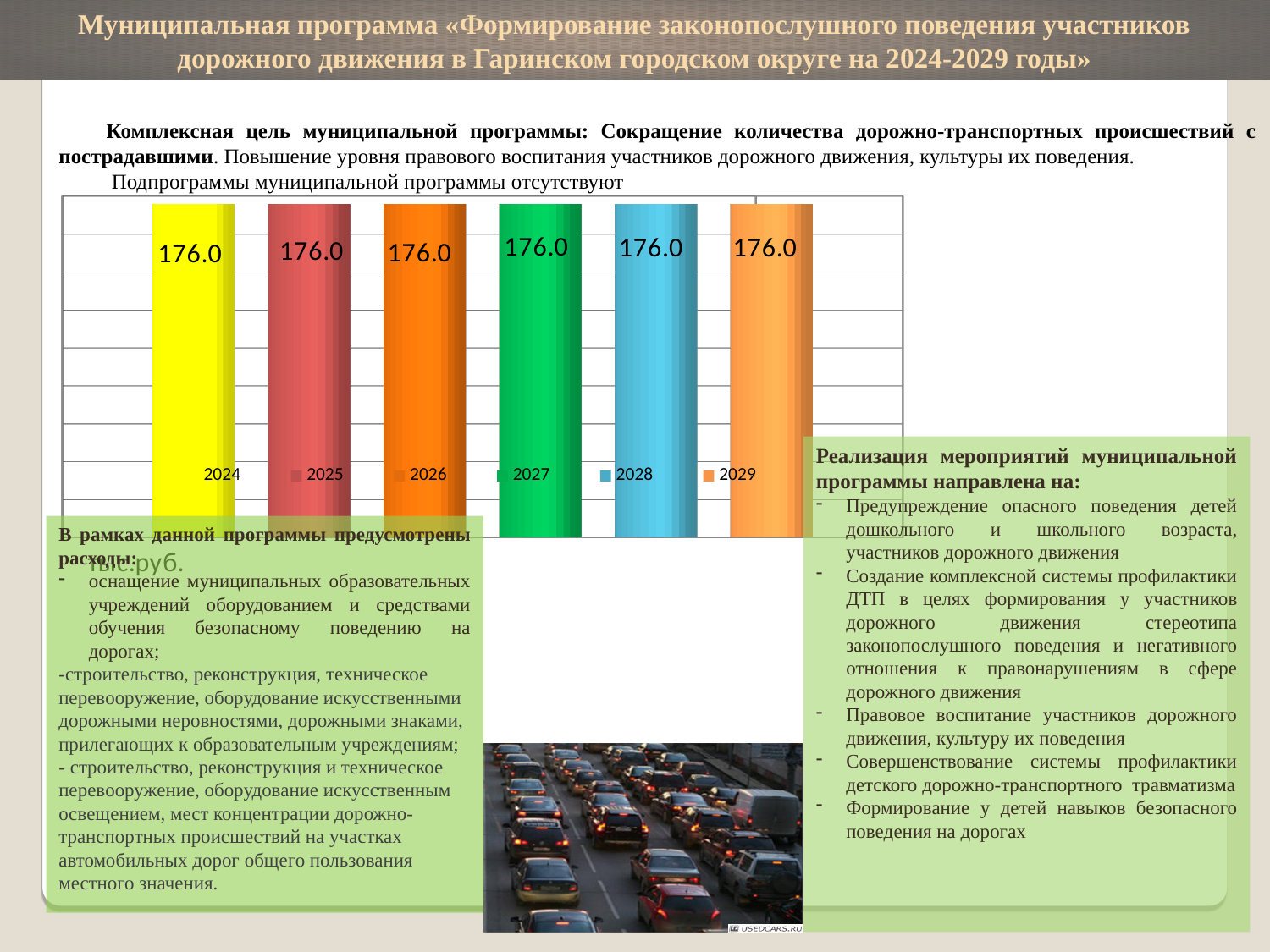
What is the value shown for 2029 on the bar chart? 176.0 What colour is the bar for 2024? Yellow Which years are covered by the bars on the chart? 2024 to 2029 What is the value shown for 2026 on the bar chart? 176.0 How many entries does the chart legend list? 6 What is the value shown for 2024 on the bar chart? 176.0 What is the value shown for 2027 on the bar chart? 176.0 Do the values rise, fall or stay the same from 2024 to 2029? Stay the same What is the difference between the values for 2025 and 2028? 0.0 How many bars (years) are plotted on the chart? 6 What kind of chart is shown on the slide? Bar chart